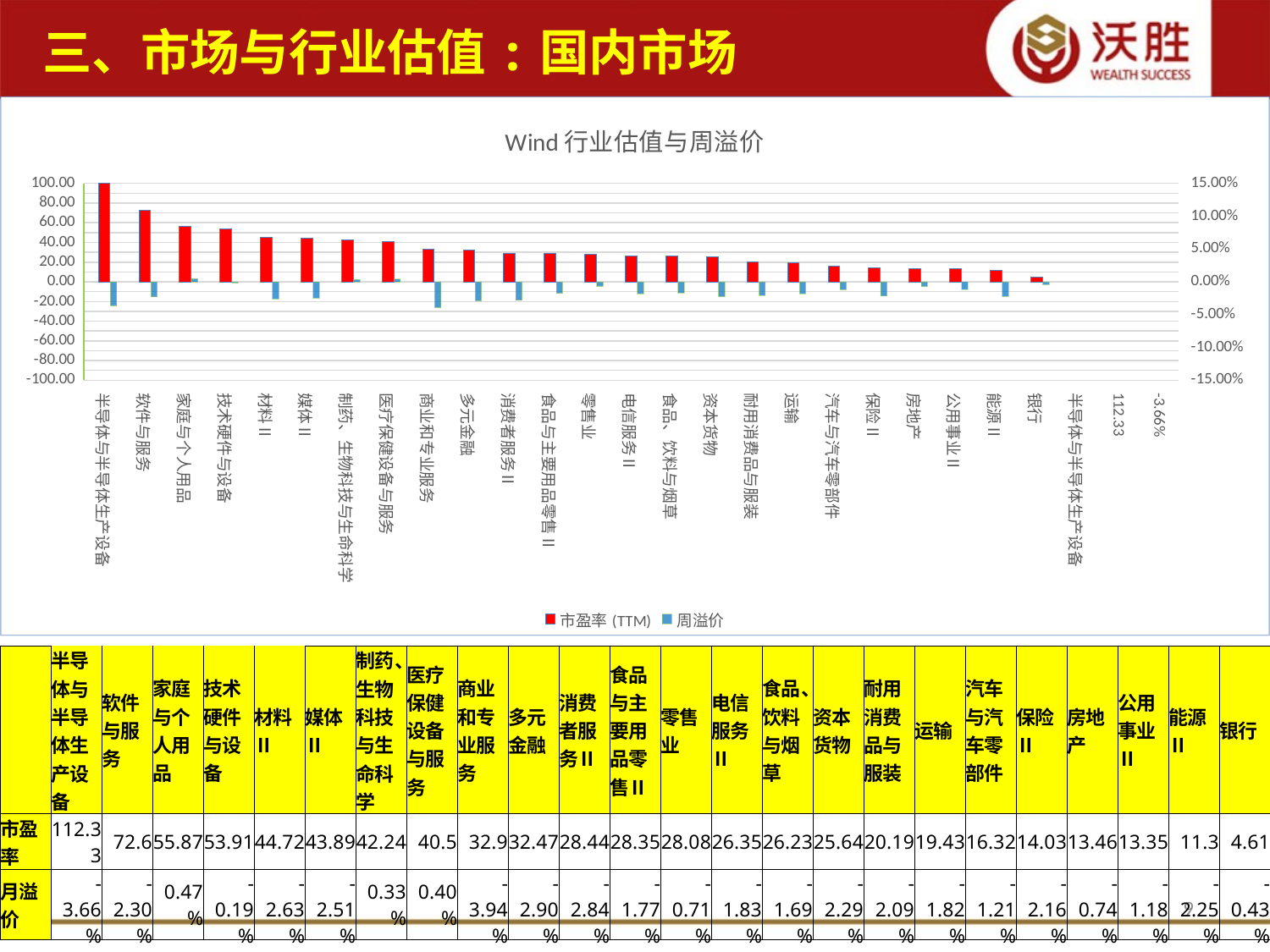
What is the difference between the 市盈率 values of 软件与服务 and 家庭与个人用品? 16.73 Which category has the lowest 市盈率 (TTM) value? 银行 Do the 市盈率 (TTM) bars rise or fall from left to right along the x axis? fall How many series does the chart legend list? 2 Which category has the highest 市盈率 (TTM) value? 半导体与半导体生产设备 Which has a larger 市盈率 value, 零售业 or 运输? 零售业 Is the 市盈率 value for 半导体与半导体生产设备 greater or less than 80.00? greater What is the 市盈率 value for 软件与服务? 72.6 What is the 周溢价 value for 半导体与半导体生产设备? -3.66% What is the 市盈率 value for 银行? 4.61 What is the title of the chart? Wind 行业估值与周溢价 What type of chart is shown on the slide? bar chart